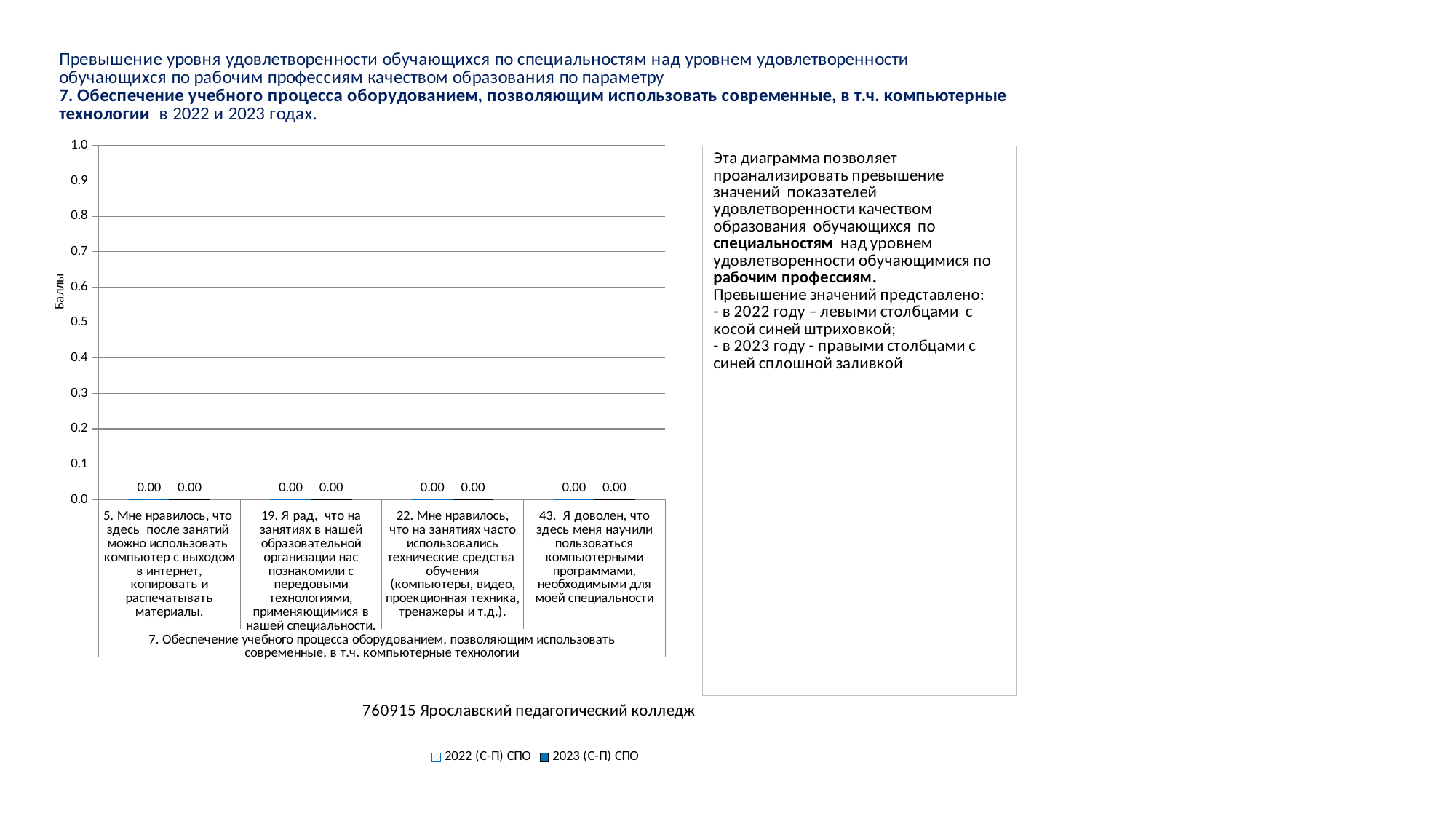
What is the title shown below the chart? 760915 Ярославский педагогический колледж What is the difference between the 2022 (С-П) СПО and 2023 (С-П) СПО values for category 43? 0.00 Is the value of the 2023 (С-П) СПО series for category 5 greater or less than 0.5? less What is the value of the 2023 (С-П) СПО series for category 43 ("Я доволен, что здесь меня научили пользоваться компьютерными программами...")? 0.00 What is the value of the 2022 (С-П) СПО series for category 22 ("Мне нравилось, что на занятиях часто использовались технические средства обучения...")? 0.00 How many series does the chart legend list? 2 How many categories are shown on the x axis of the chart? 4 What is the maximum value shown on the y axis of the chart? 1.0 What is the value of the 2022 (С-П) СПО series for category 5 ("Мне нравилось, что здесь после занятий можно использовать компьютер с выходом в интернет...")? 0.00 What type of chart is shown on the slide? bar chart What is the label of the y axis of the chart? Баллы What is the value of the 2023 (С-П) СПО series for category 19 ("Я рад, что на занятиях в нашей образовательной организации нас познакомили с передовыми технологиями...")? 0.00